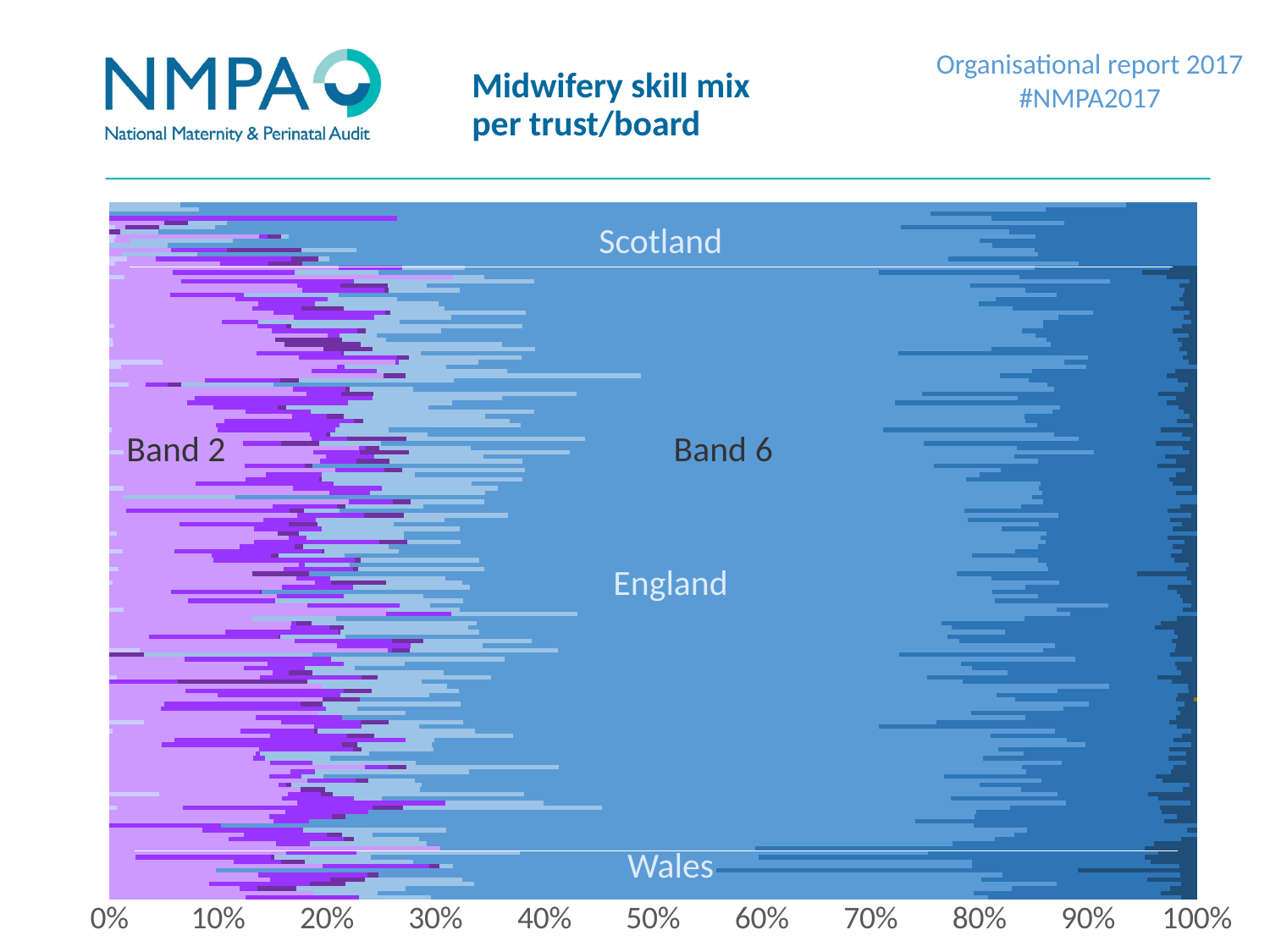
Which country's boards are shown at the top of the chart? Scotland Which band occupies the largest share of the bars across trusts/boards? Band 6 Is the Band 2 share for the trusts/boards greater or less than 40%? less How many countries are labelled on the chart? 3 What kind of chart is shown on the slide? Bar chart What is the highest value shown on the x axis? 100% Which two bands are labelled inside the chart? Band 2 and Band 6 What is the interval between the tick marks on the x axis? 10% Which country's trusts/boards are shown at the bottom of the chart? Wales What is the title of the chart on the slide? Midwifery skill mix per trust/board